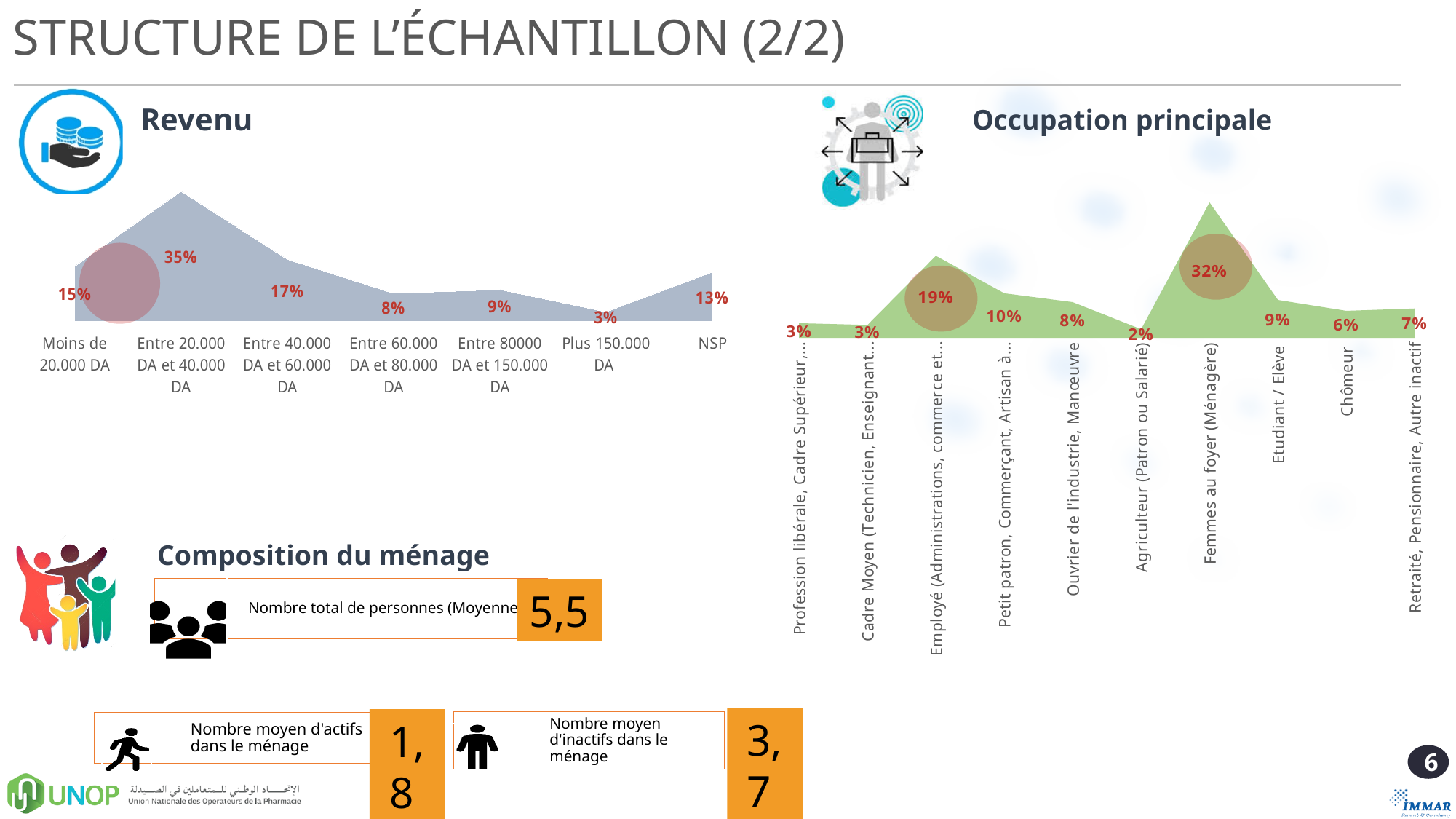
In the Revenu chart, what is the value for NSP? 13% In the Revenu chart, what is the value for Entre 20.000 DA et 40.000 DA? 35% In the Occupation principale chart, what is the value for Femmes au foyer (Ménagère)? 32% What type of chart is the Revenu chart? Area chart In the Occupation principale chart, what is the value for Chômeur? 6% In the Occupation principale chart, which occupation has the lowest value? Agriculteur (Patron ou Salarié) In the Revenu chart, what is the difference between Moins de 20.000 DA and Entre 40.000 DA et 60.000 DA? 2 percentage points In the Occupation principale chart, how many occupation categories are shown? 10 In the Revenu chart, which income category has the highest value? Entre 20.000 DA et 40.000 DA In the Revenu chart, how many income categories are shown? 7 In the Revenu chart, which income category has the lowest value? Plus 150.000 DA In the Occupation principale chart, which is larger: Etudiant / Elève or Retraité, Pensionnaire, Autre inactif? Etudiant / Elève